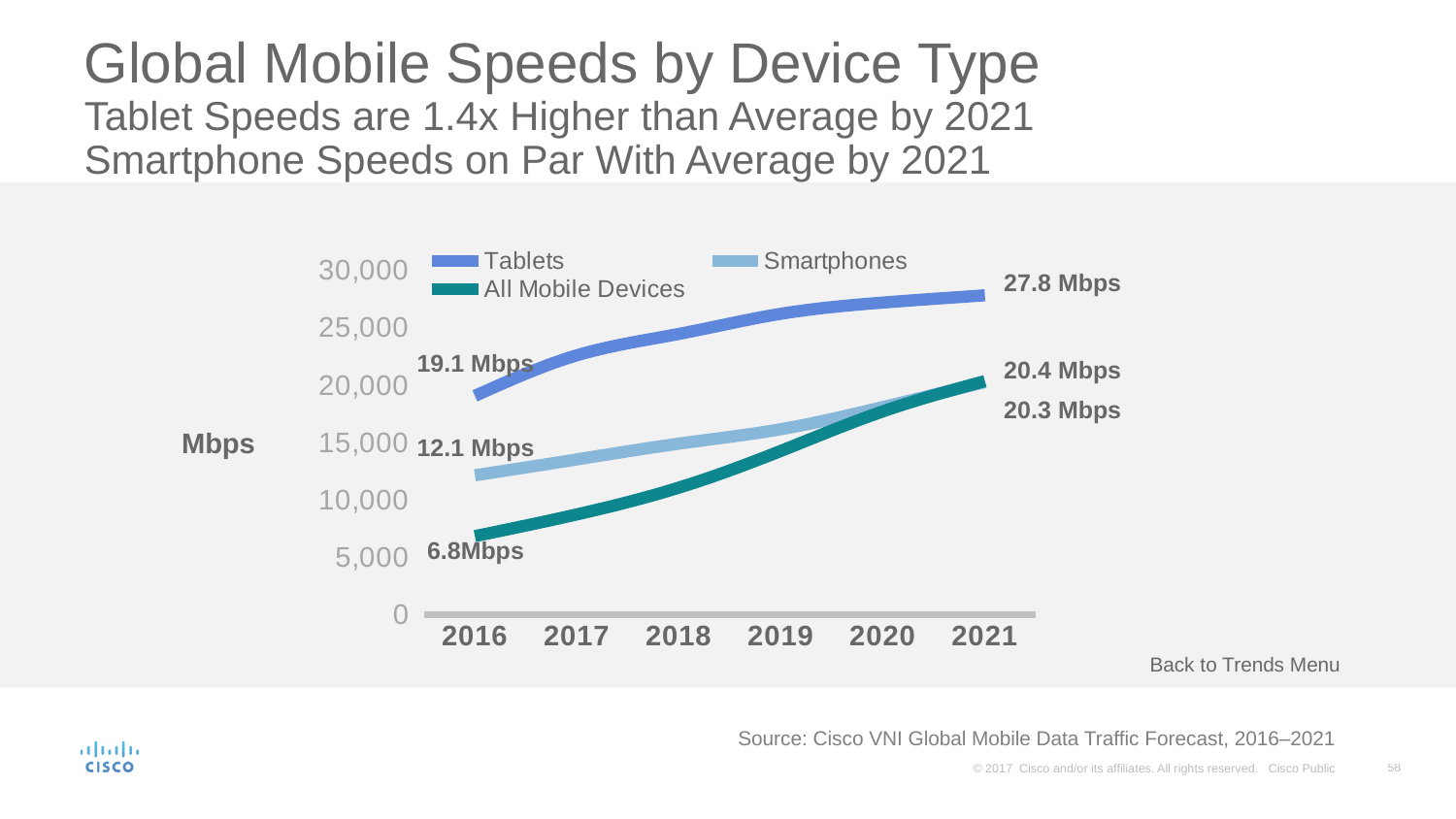
How many years are shown on the x axis? 6 By how much did the Tablets value increase from 2016 to 2021? 8.7 Mbps Which series has the lowest value in 2016? All Mobile Devices Which series has the highest value in 2016? Tablets What is the value for All Mobile Devices in 2016? 6.8Mbps Do the values for All Mobile Devices rise or fall from 2016 to 2021? rise What kind of chart is shown on the slide? line chart What is the value for Tablets in 2021? 27.8 Mbps What is the value for Smartphones in 2016? 12.1 Mbps How many series does the legend list? 3 Is the value for Tablets in 2018 greater or less than 20,000? greater What is the value for Tablets in 2016? 19.1 Mbps